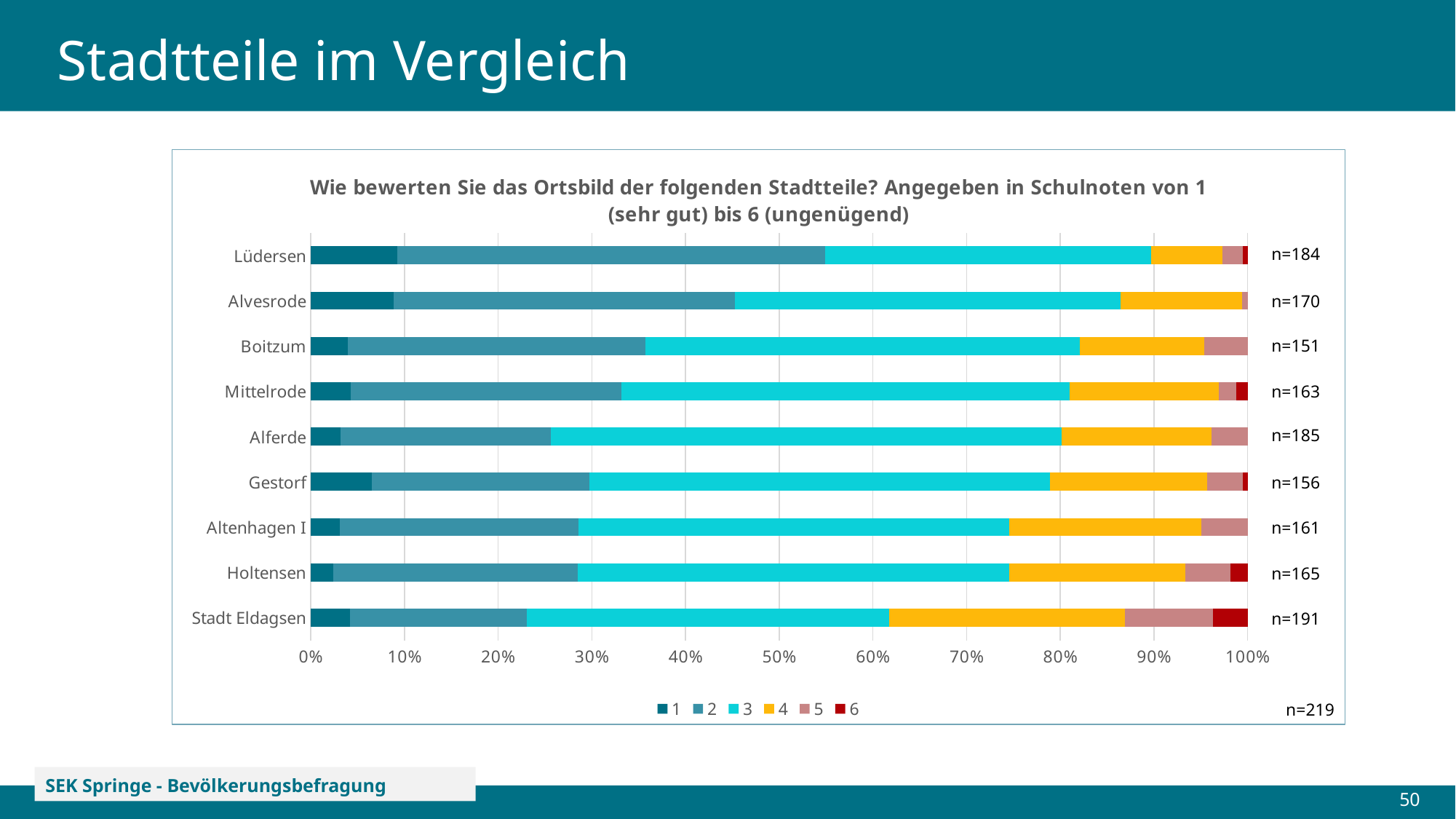
What is the n value printed next to the bar for Lüdersen? n=184 What is the n value printed next to the bar for Boitzum? n=151 Which has the larger n value, Alferde or Lüdersen? Alferde Which Stadtteil has the largest n value printed next to its bar? Stadt Eldagsen How many series does the legend list? 6 Is the share of grade 1 for Gestorf greater or less than 10%? less How many Stadtteile (categories) are plotted in the chart? 9 Which Stadtteil has the smallest n value printed next to its bar? Boitzum Is the combined share of grades 1 and 2 for Lüdersen greater or less than 50%? greater What is the difference between the n values for Stadt Eldagsen and Boitzum? 40 What kind of chart is shown on the slide? Stacked bar chart Which Stadtteil has the largest share of grade 6 (ungenügend)? Stadt Eldagsen